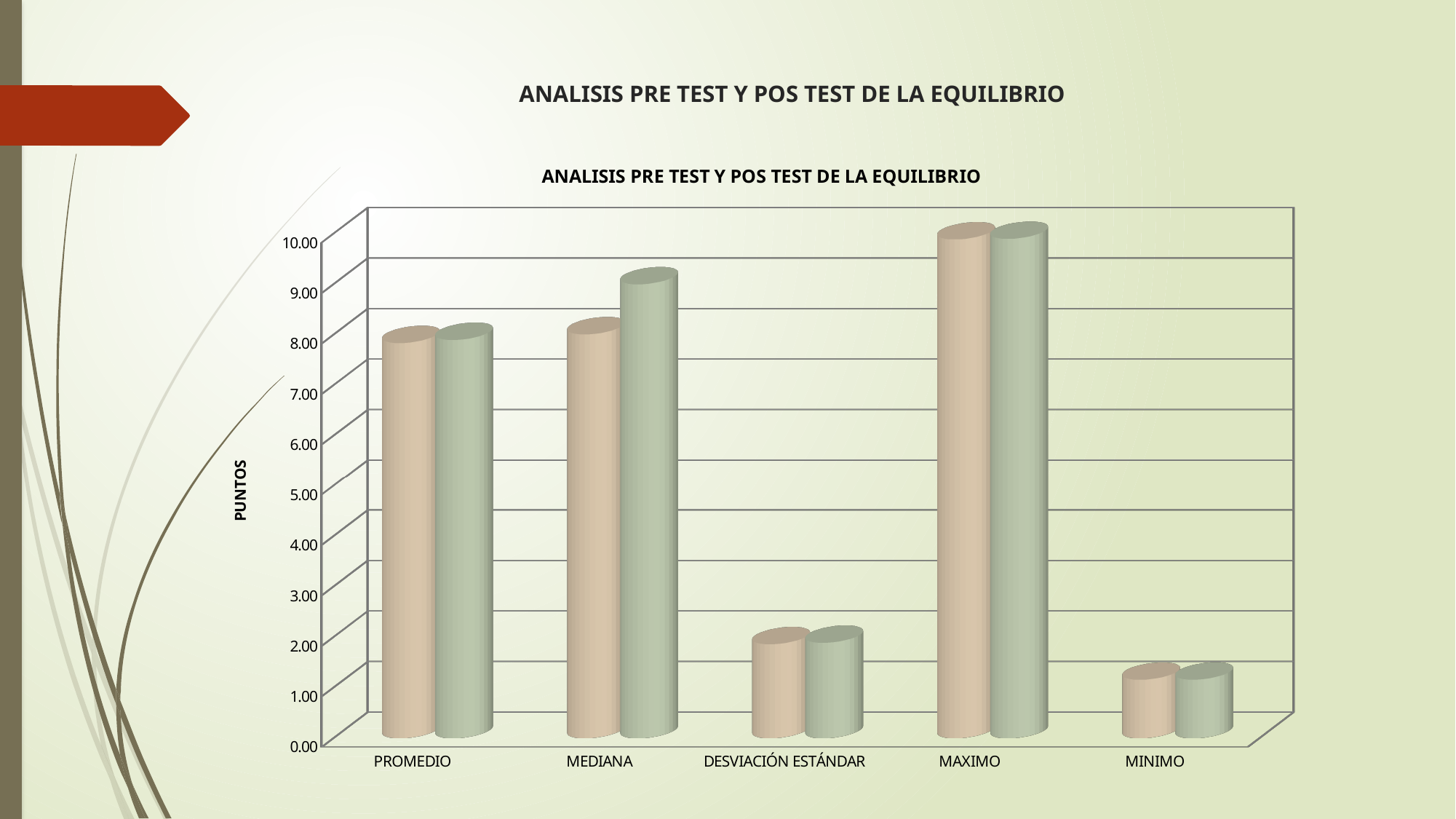
Is the value for DESVIACIÓN ESTÁNDAR larger or smaller than the value for PROMEDIO? smaller Are the values for PROMEDIO greater or less than 6.00? greater Are the values for MINIMO greater or less than 2.00? less Are the values for MAXIMO greater or less than 9.00? greater What is the title of the chart? ANALISIS PRE TEST Y POS TEST DE LA EQUILIBRIO What kind of chart is shown on the slide? bar chart Which category has the shortest bars in the chart? MINIMO What is the label on the vertical axis of the chart? PUNTOS Which category has the tallest bars in the chart? MAXIMO Is the value for MAXIMO larger or smaller than the value for MEDIANA? larger How many categories are shown on the x axis of the chart? 5